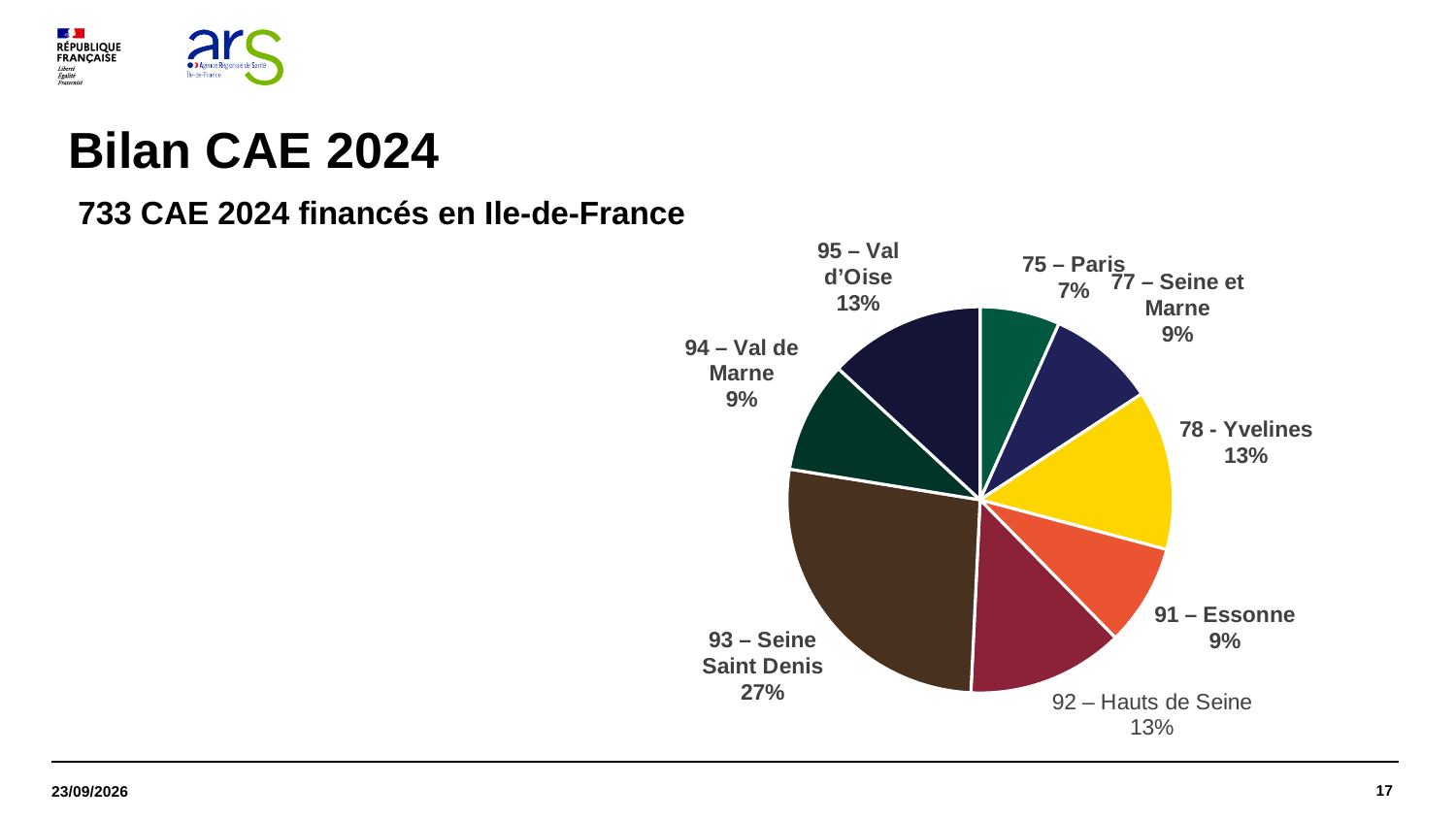
What is the value shown for 78 - Yvelines? 13% What is the value shown for 91 – Essonne? 9% What is the difference in percentage points between 93 – Seine Saint Denis and 92 – Hauts de Seine? 14 How many slices does the pie chart have? 8 According to the slide subtitle, how many CAE 2024 were financed in Ile-de-France? 733 What kind of chart is shown on the slide? pie chart What is the value shown for 75 – Paris? 7% Which department has the smallest slice of the pie? 75 – Paris What share of the pie does 93 – Seine Saint Denis represent? 27% What is the difference in percentage points between 94 – Val de Marne and 75 – Paris? 2 Which department has the largest slice of the pie? 93 – Seine Saint Denis Which is larger, the share for 77 – Seine et Marne or the share for 95 – Val d'Oise? 95 – Val d'Oise